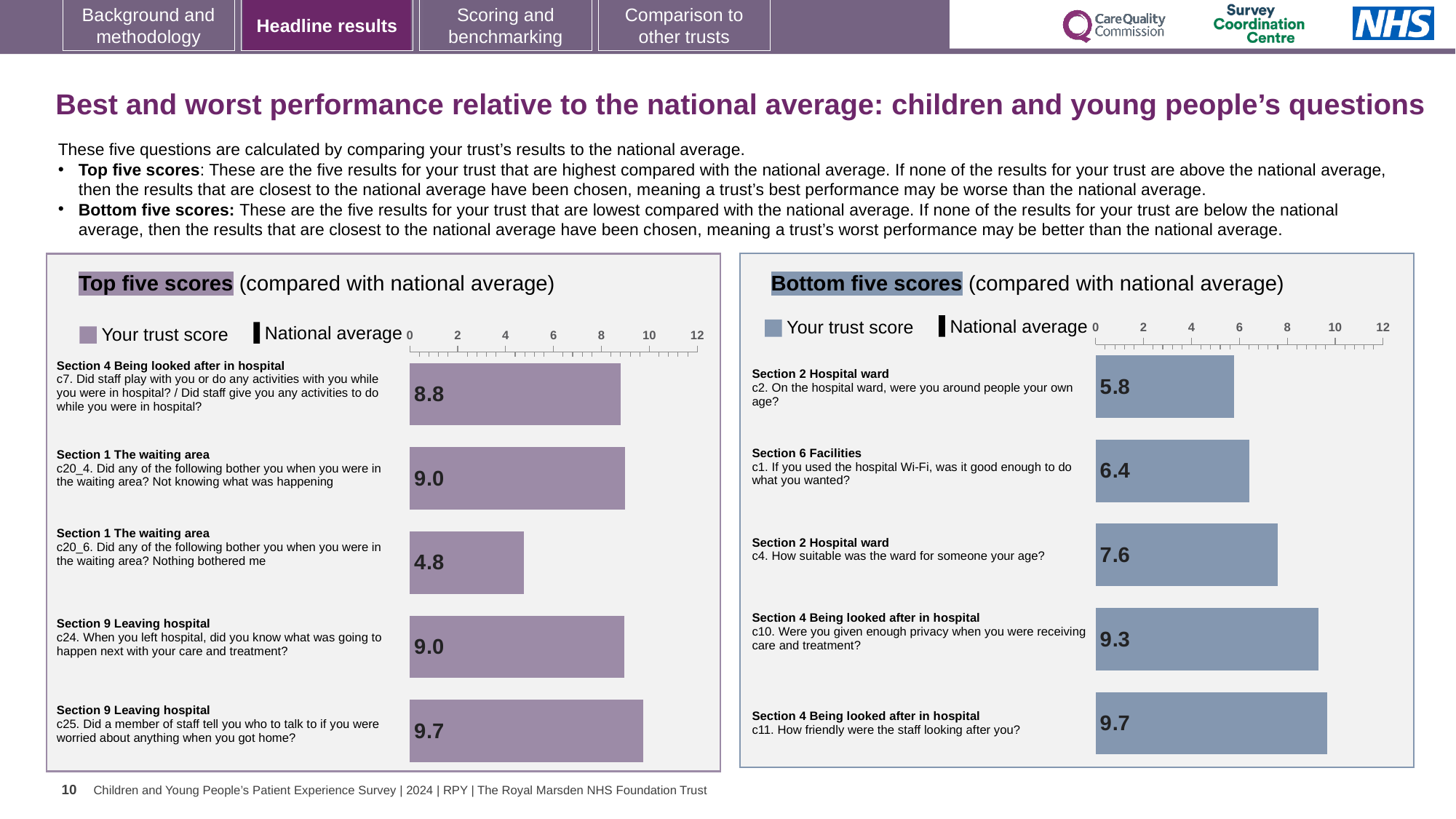
In the Top five scores chart, what is the trust score for c7 (Did staff play with you or do any activities with you while you were in hospital?)? 8.8 In the Top five scores chart, what is the difference between the trust scores for c25 and c20_6? 4.9 In the Bottom five scores chart, which has the larger trust score: c4 (How suitable was the ward for someone your age?) or c1 (hospital Wi-Fi)? c4 In the Top five scores chart, which question has the lowest trust score? c20_6. Did any of the following bother you when you were in the waiting area? Nothing bothered me In the Bottom five scores chart, what is the trust score for c1 (If you used the hospital Wi-Fi, was it good enough to do what you wanted?)? 6.4 In the Top five scores chart, is the trust score for c20_6 greater or less than 6? less In the Bottom five scores chart, which question has the lowest trust score? c2. On the hospital ward, were you around people your own age? In the Top five scores chart, which question has the highest trust score? c25. Did a member of staff tell you who to talk to if you were worried about anything when you got home? In the Bottom five scores chart, what is the difference between the trust scores for c11 and c2? 3.9 How many questions are plotted in the Bottom five scores chart? 5 In the Bottom five scores chart, what is the trust score for c10 (Were you given enough privacy when you were receiving care and treatment?)? 9.3 What kind of chart is the Top five scores chart? bar chart